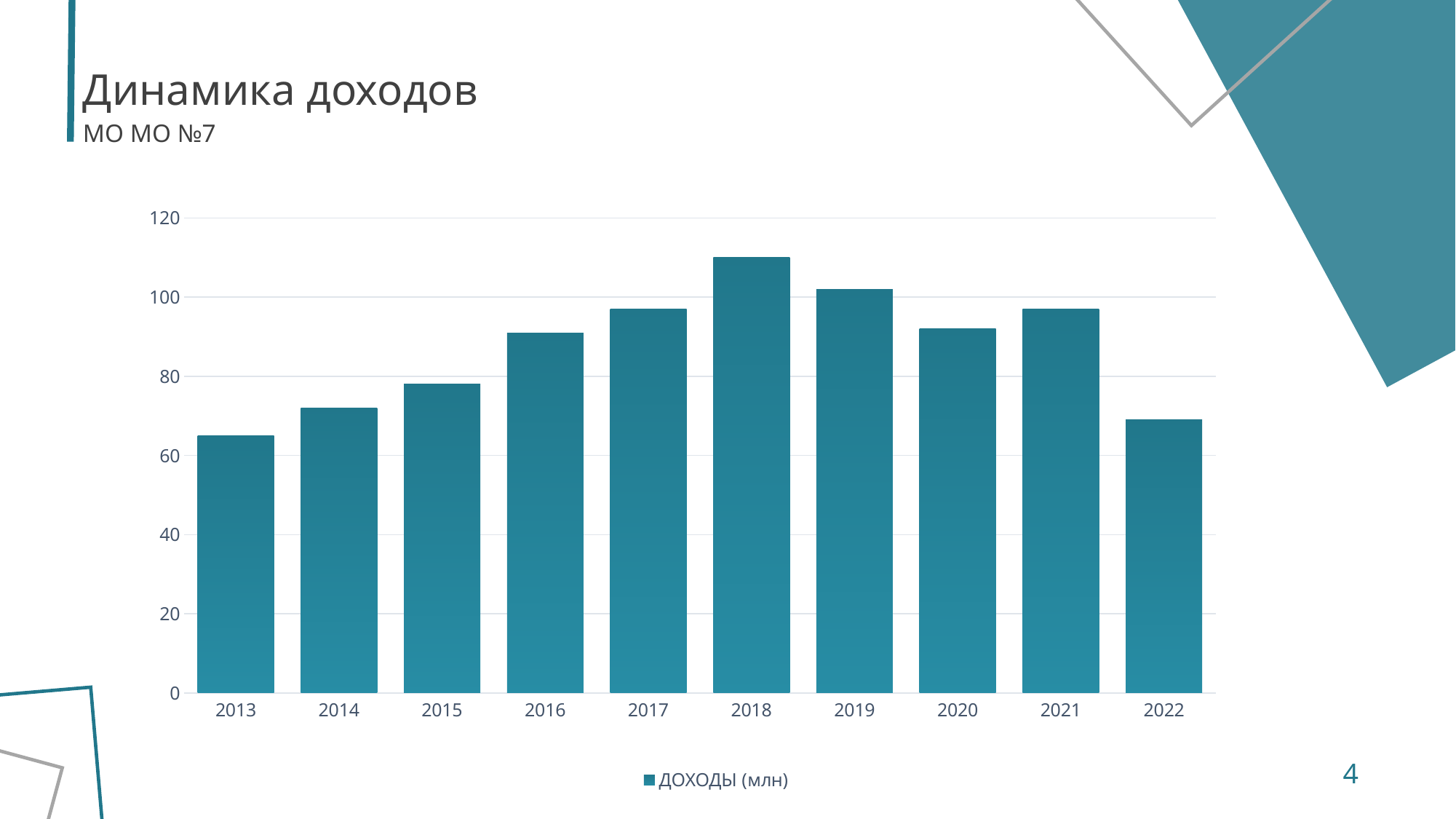
Is the value for 2016 greater or less than 100? less Which year has the highest value for ДОХОДЫ (млн)? 2018 What kind of chart is shown on the slide? bar chart Is the value for 2018 greater or less than 100? greater How many years are shown on the x axis of the chart? 10 Is the value for 2022 greater or less than 60? greater What is the series name shown in the legend? ДОХОДЫ (млн) Which is larger, the value for 2018 or the value for 2019? 2018 Which year has the lowest value for ДОХОДЫ (млн)? 2013 How many series does the legend list? 1 Do the values rise or fall from 2013 to 2018? rise